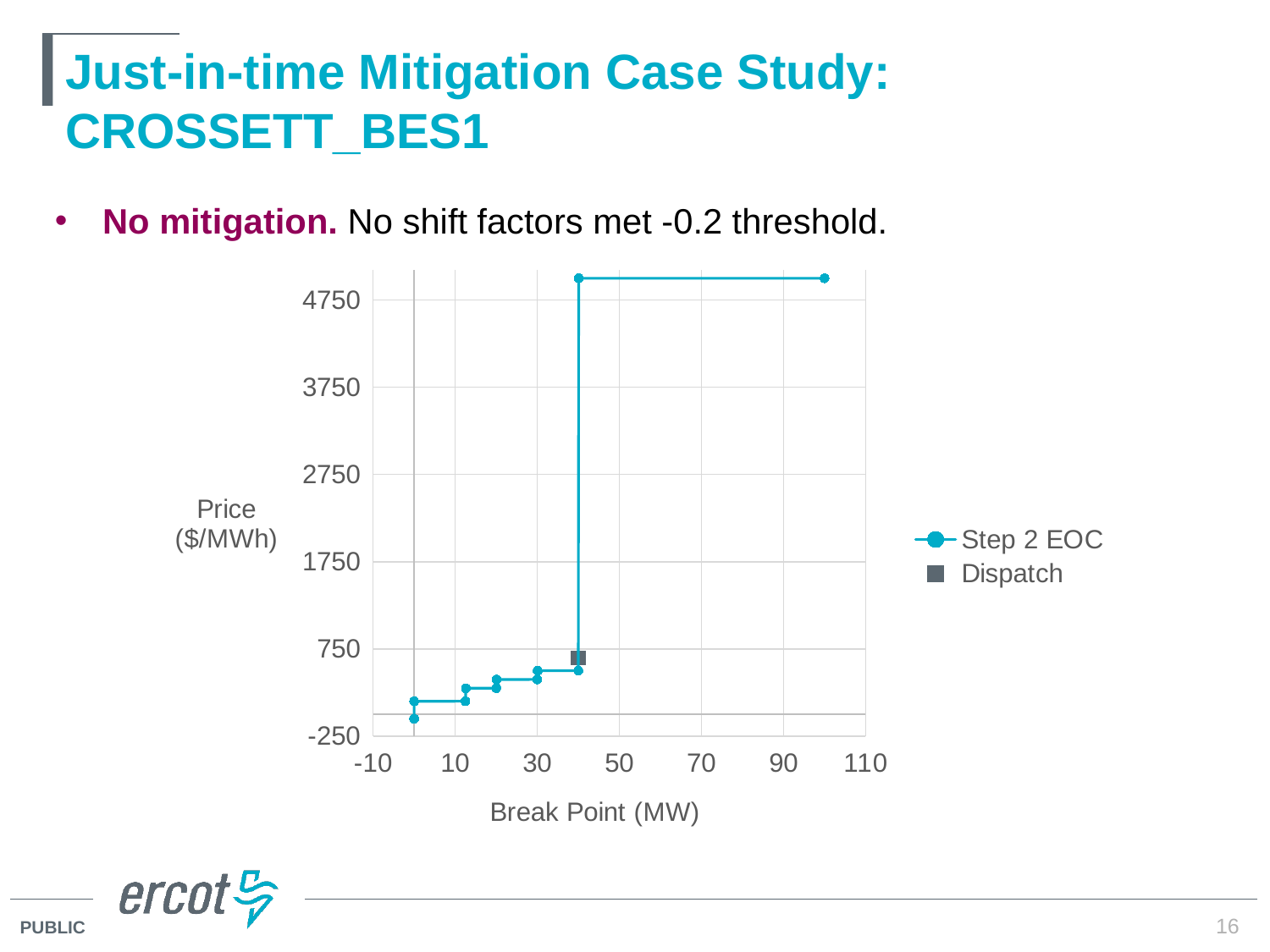
What are the two series named in the chart legend? Step 2 EOC and Dispatch Which is larger, the Step 2 EOC price at a break point of 100 MW or at a break point of 20 MW? 100 MW What is the highest value shown on the y axis of the chart? 4750 What is the label of the x axis of the chart? Break Point (MW) Is the Dispatch point's break point greater or less than 30 MW? greater Is the Step 2 EOC price at a break point of 100 MW greater or less than 3750 $/MWh? greater Is the Step 2 EOC price at a break point of 0 MW greater or less than 750 $/MWh? less Does the Step 2 EOC price rise or fall as the break point increases along the x axis? rise How many series does the chart legend list? 2 What kind of chart is shown on the slide? line chart